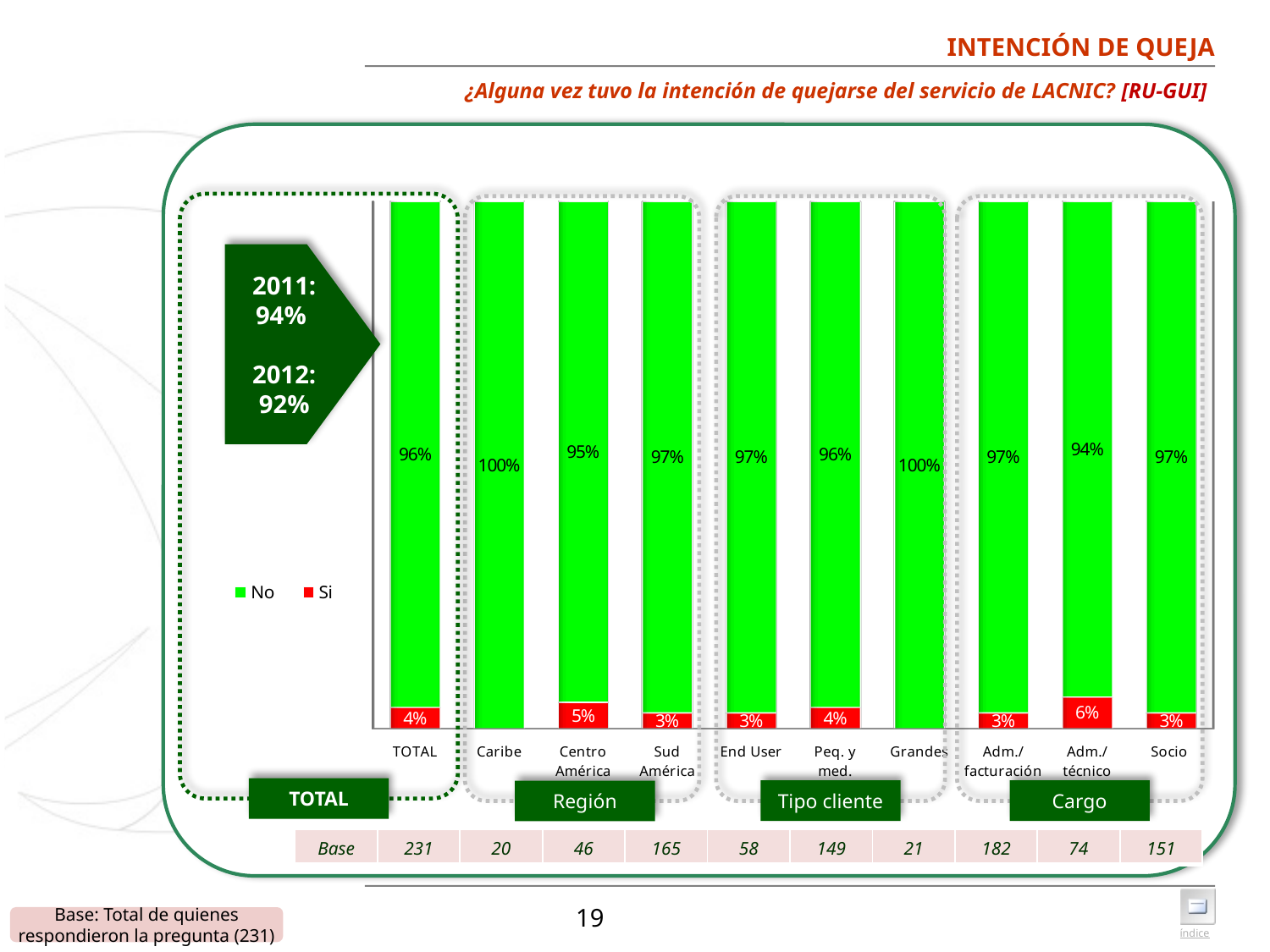
What is the "Si" value for Adm./técnico? 6% What kind of chart is shown on the slide? Stacked bar chart What is the "No" value for Centro América? 95% How many series does the legend list? 2 Which colour represents the "Si" series in the chart? Red What is the difference between the "Si" values for Adm./técnico and Sud América? 3% How many categories are shown on the x axis of the chart? 10 What percentage of TOTAL respondents answered "No"? 96% Which category has the highest "Si" value? Adm./técnico Which has a larger "No" value, Caribe or Centro América? Caribe What is the "Si" value for Peq. y med.? 4% Which category has the lowest "No" value? Adm./técnico